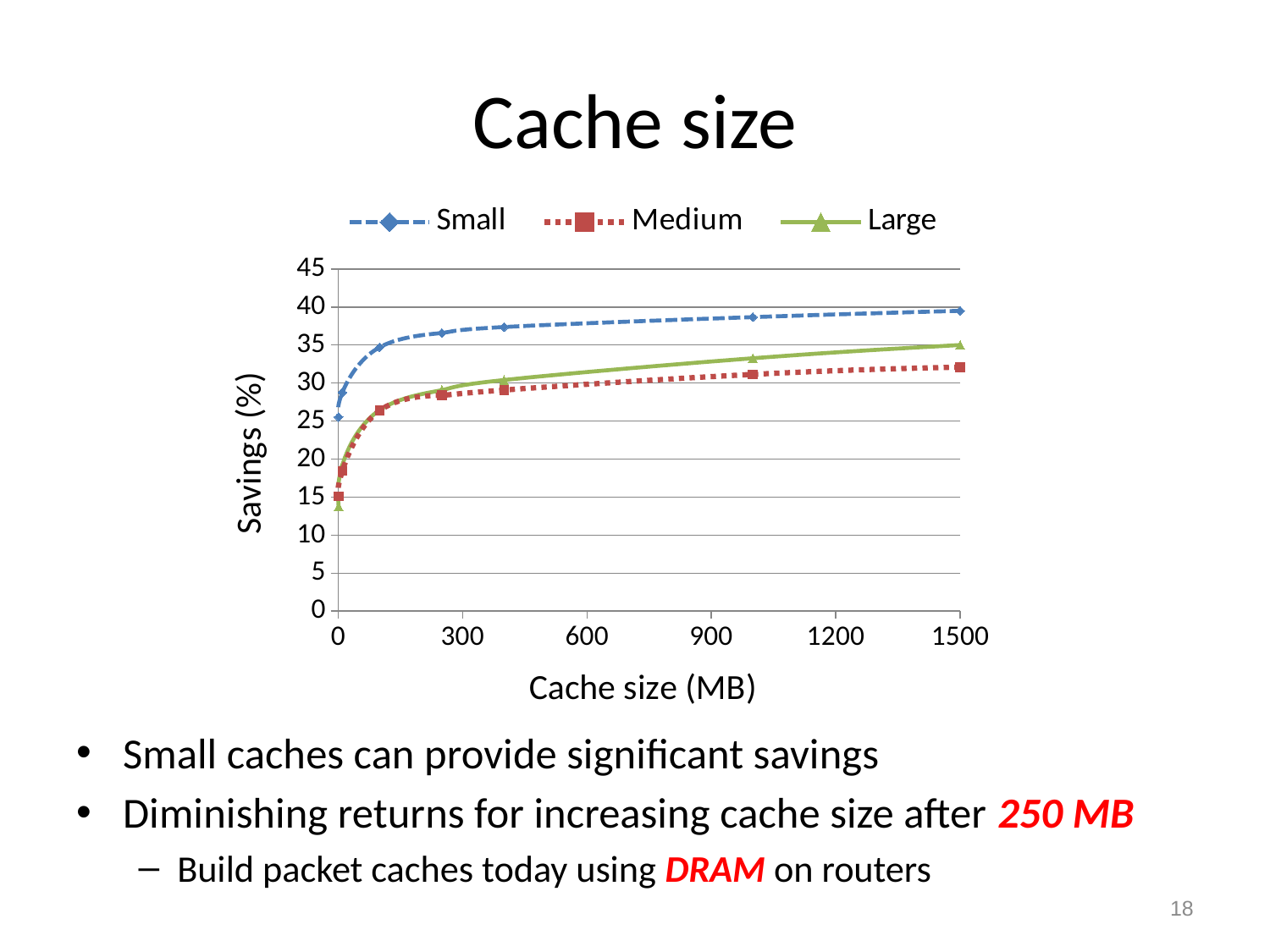
At a cache size of 1500 MB, which series has higher savings, Small or Medium? Small Is the savings value for the Medium series at a cache size of 0 MB greater or less than 20? less Is the savings value for the Medium series at 1500 MB greater or less than 30? greater Do the savings values for the Large series rise or fall as cache size increases? rise Which series has the lowest savings at a cache size of 1500 MB? Medium What is the label of the y axis? Savings (%) Which series has the highest savings at a cache size of 1500 MB? Small What are the names of the series in the legend? Small, Medium, Large What kind of chart is shown on the slide? line chart How many series does the legend list? 3 Is the savings value for the Small series at 1500 MB greater or less than 35? greater At a cache size of 1500 MB, which series has higher savings, Large or Medium? Large